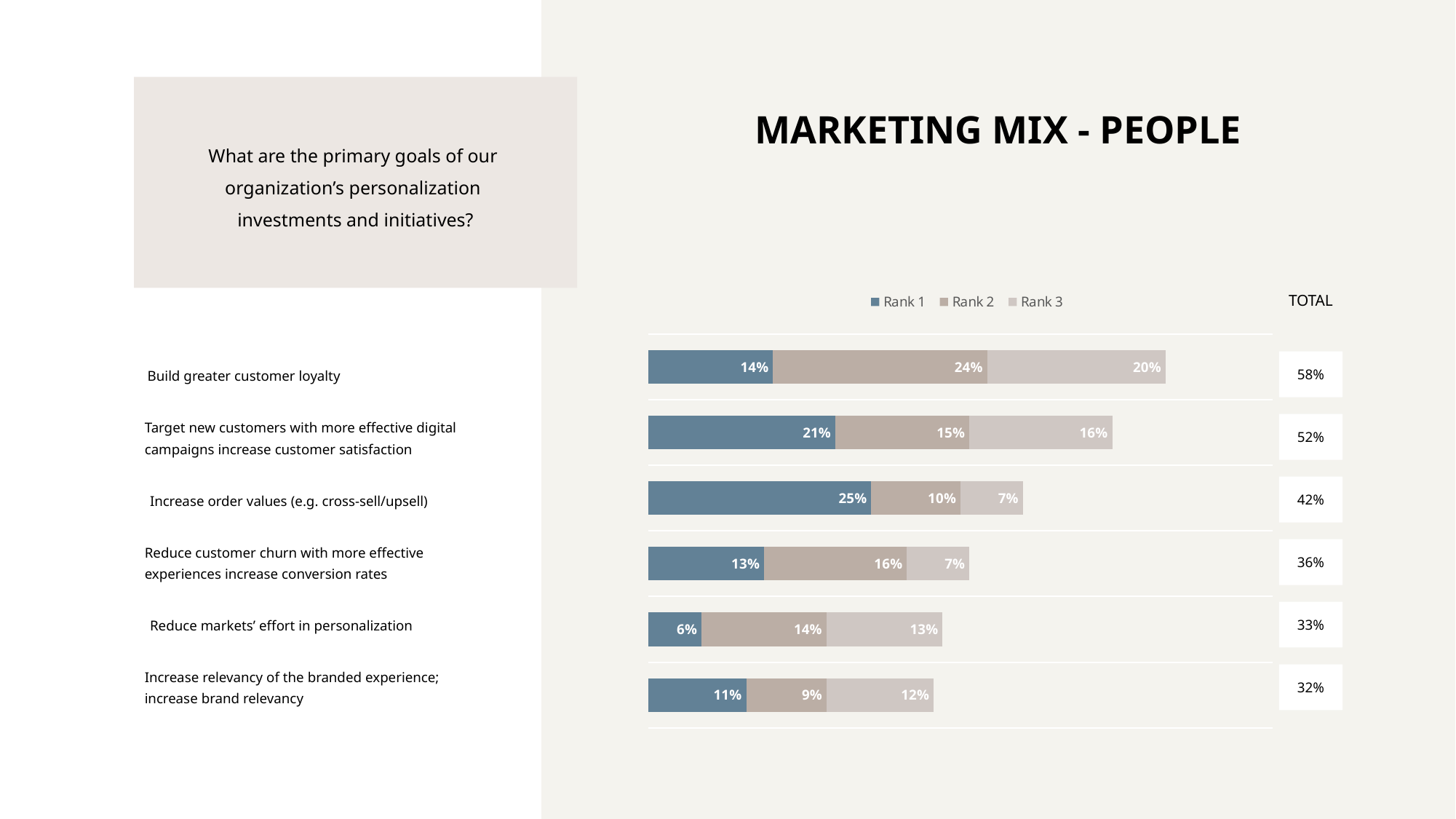
Which is larger: the Rank 2 value for "Reduce customer churn with more effective experiences increase conversion rates" or the Rank 2 value for "Increase relevancy of the branded experience; increase brand relevancy"? Reduce customer churn with more effective experiences increase conversion rates What is the Rank 3 value for "Reduce markets' effort in personalization"? 13% Which category has the lowest Rank 1 value? Reduce markets' effort in personalization How many categories are shown in the chart? 6 Which category has the highest Rank 1 value? Increase order values (e.g. cross-sell/upsell) What is the Rank 2 value for "Build greater customer loyalty"? 24% What is the total for "Reduce customer churn with more effective experiences increase conversion rates"? 36% What kind of chart is shown on the slide? Stacked bar chart How many series does the legend list? 3 What is the Rank 1 value for "Increase order values (e.g. cross-sell/upsell)"? 25% What is the difference between the Rank 1 values for "Increase order values (e.g. cross-sell/upsell)" and "Build greater customer loyalty"? 11% What is the total for "Build greater customer loyalty"? 58%